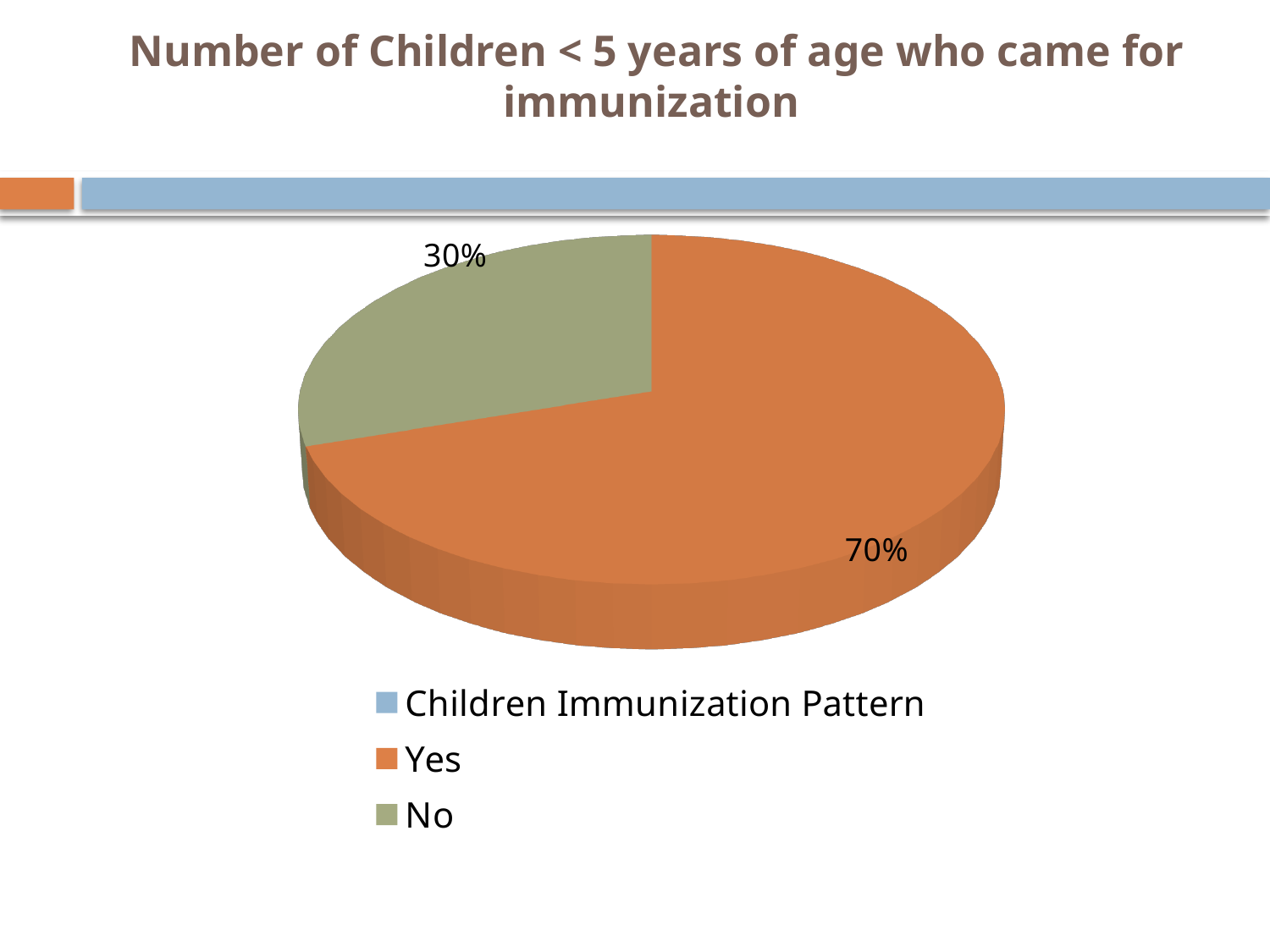
What is the difference in percentage points between the 'Yes' and 'No' slices? 40 What colour is the 'Yes' slice in the pie chart? orange Which is larger, the 'Yes' slice or the 'No' slice? Yes Which slice of the pie is the smallest? No What percentage of the pie is labelled for the 'Yes' slice? 70% What kind of chart is shown on the slide? pie chart What is the title of the slide? Number of Children < 5 years of age who came for immunization Which slice of the pie is the largest? Yes What percentage of the pie is labelled for the 'No' slice? 30% How many entries does the legend list? 3 How many slices with data labels does the pie chart have? 2